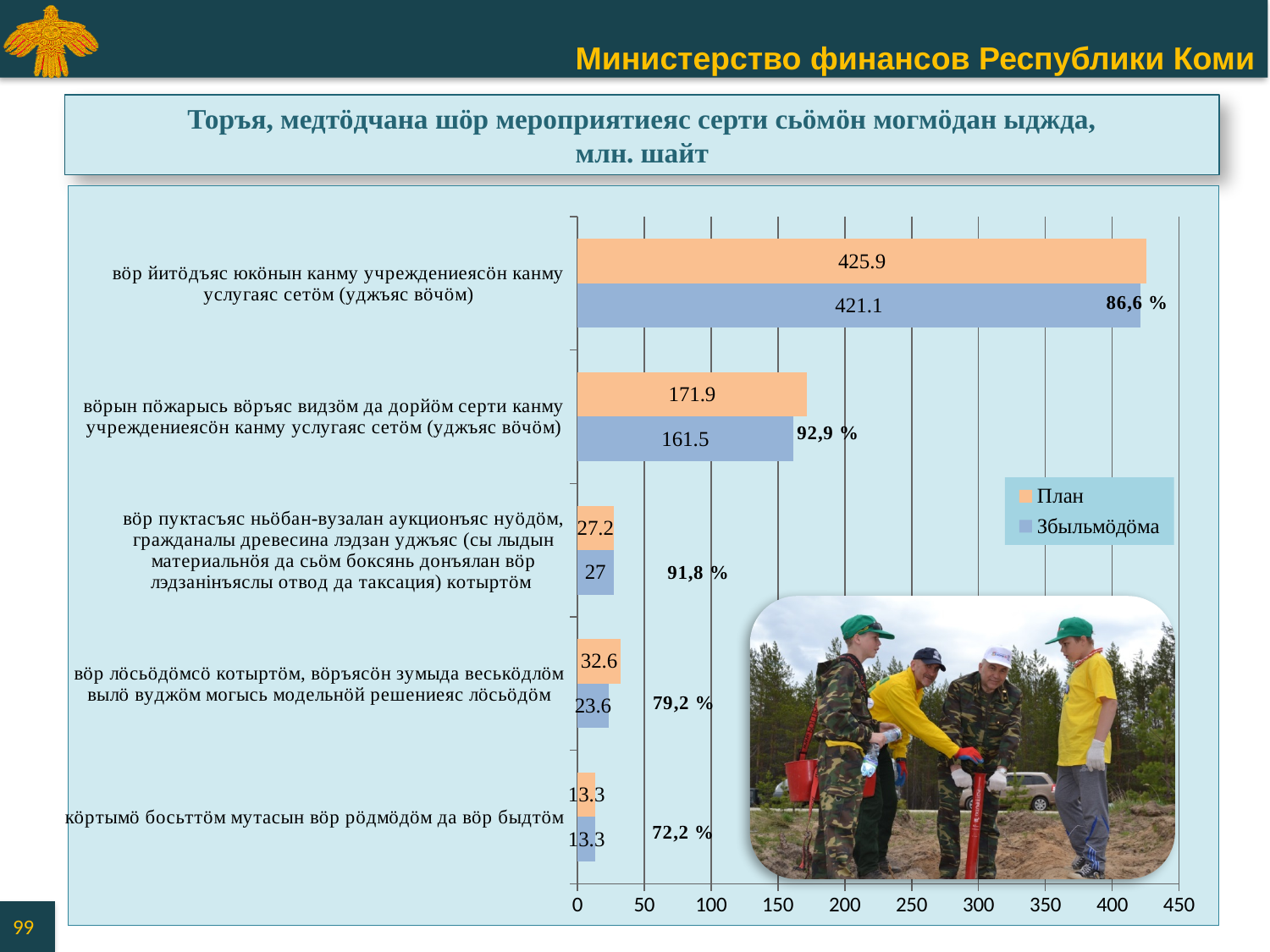
What kind of chart is shown on the slide? Bar chart Which is larger: the План value for "вӧр лӧсьӧдӧмсӧ котыртӧм..." (32.6) or the План value for "вӧр пуктасъяс ньӧбан-вузалан аукционъяс нуӧдӧм..." (27.2)? вӧр лӧсьӧдӧмсӧ котыртӧм... (32.6) What is the difference between the План and Збыльмӧдӧма values for the category "вӧрын пӧжарысь вӧръяс видзӧм да дорйӧм серти канму учреждениеясӧн канму услугаяс сетӧм (уджъяс вӧчӧм)"? 10.4 What is the Збыльмӧдӧма value for the category "вӧрын пӧжарысь вӧръяс видзӧм да дорйӧм серти канму учреждениеясӧн канму услугаяс сетӧм (уджъяс вӧчӧм)"? 161.5 How many series does the legend list? 2 How many categories are shown on the chart? 5 What is the Збыльмӧдӧма value for the category "вӧр лӧсьӧдӧмсӧ котыртӧм, вӧръясӧн зумыда веськӧдлӧм вылӧ вуджӧм могысь модельнӧй решениеяс лӧсьӧдӧм"? 23.6 What is the План value for the top category "вӧр йитӧдъяс юкӧнын канму учреждениеясӧн канму услугаяс сетӧм (уджъяс вӧчӧм)"? 425.9 Which category has the highest План value? вӧр йитӧдъяс юкӧнын канму учреждениеясӧн канму услугаяс сетӧм (уджъяс вӧчӧм) Which category has the lowest Збыльмӧдӧма value? кӧртымӧ босьттӧм мутасын вӧр рӧдмӧдӧм да вӧр быдтӧм What percentage is printed next to the bars for the category "вӧр пуктасъяс ньӧбан-вузалан аукционъяс нуӧдӧм..."? 91,8 % What is the План value for the category "кӧртымӧ босьттӧм мутасын вӧр рӧдмӧдӧм да вӧр быдтӧм"? 13.3